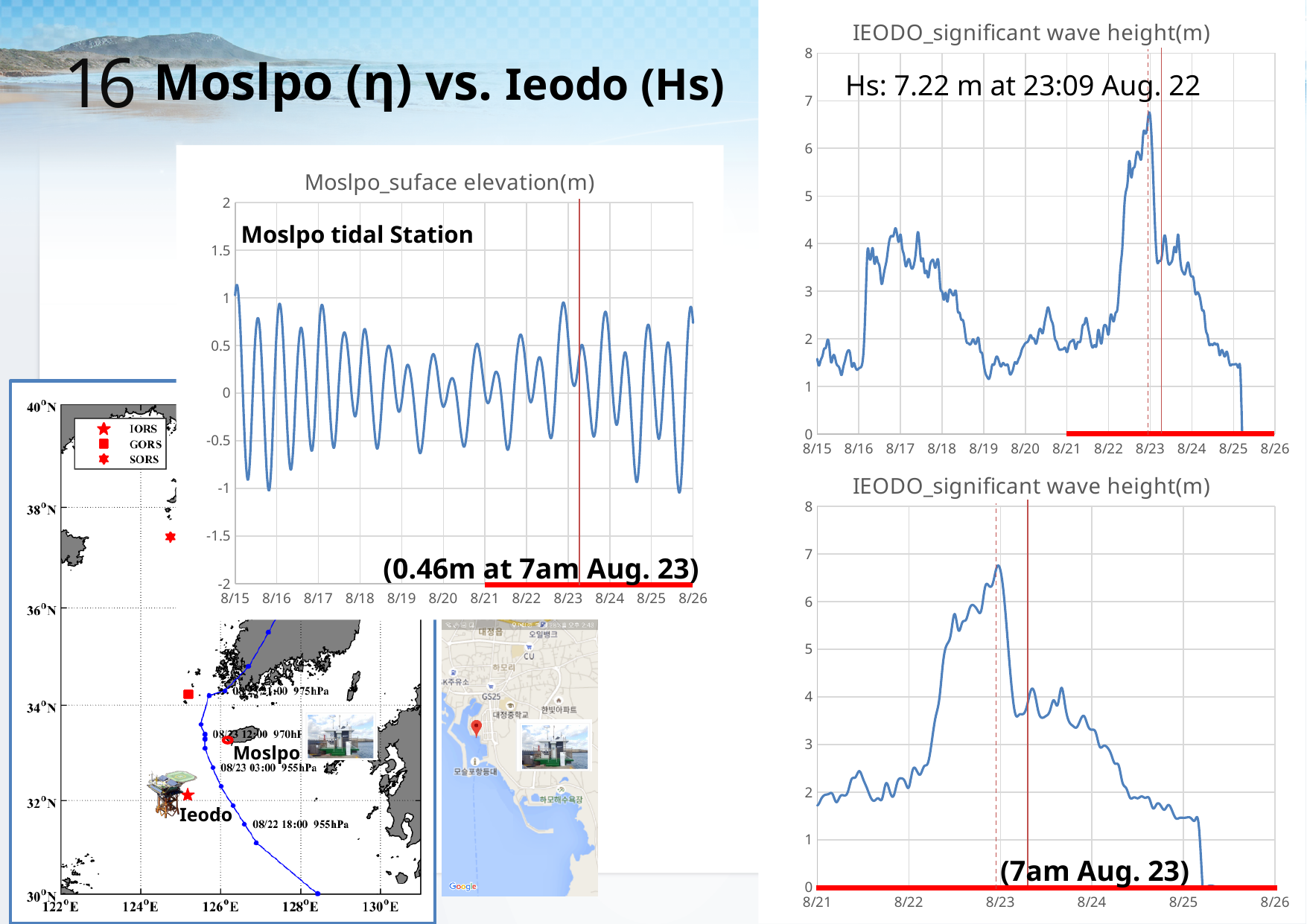
On the top IEODO_significant wave height(m) chart, at what time did the labelled peak Hs of 7.22 m occur? 23:09 Aug. 22 On the bottom IEODO_significant wave height(m) chart, does the wave height rise or fall between 8/24 and 8/25? fall On the top IEODO_significant wave height(m) chart, is the wave height at the 8/17 tick greater or less than 3? greater On the Moslpo_suface elevation(m) chart, is the highest surface elevation plotted greater or less than 1.5? less On the Moslpo_suface elevation(m) chart, what surface elevation is labelled at 7am Aug. 23? 0.46m How many date labels are shown on the x axis of the bottom IEODO_significant wave height(m) chart? 6 On the top IEODO_significant wave height(m) chart, is the wave height at the 8/19 tick greater or less than 2? less On the top IEODO_significant wave height(m) chart, what is the peak significant wave height Hs labelled on the chart? 7.22 m What is the maximum value shown on the y axis of the IEODO_significant wave height(m) charts? 8 What is the title of the chart in the top-right of the slide? IEODO_significant wave height(m) What kind of chart is the Moslpo_suface elevation(m) chart? line chart